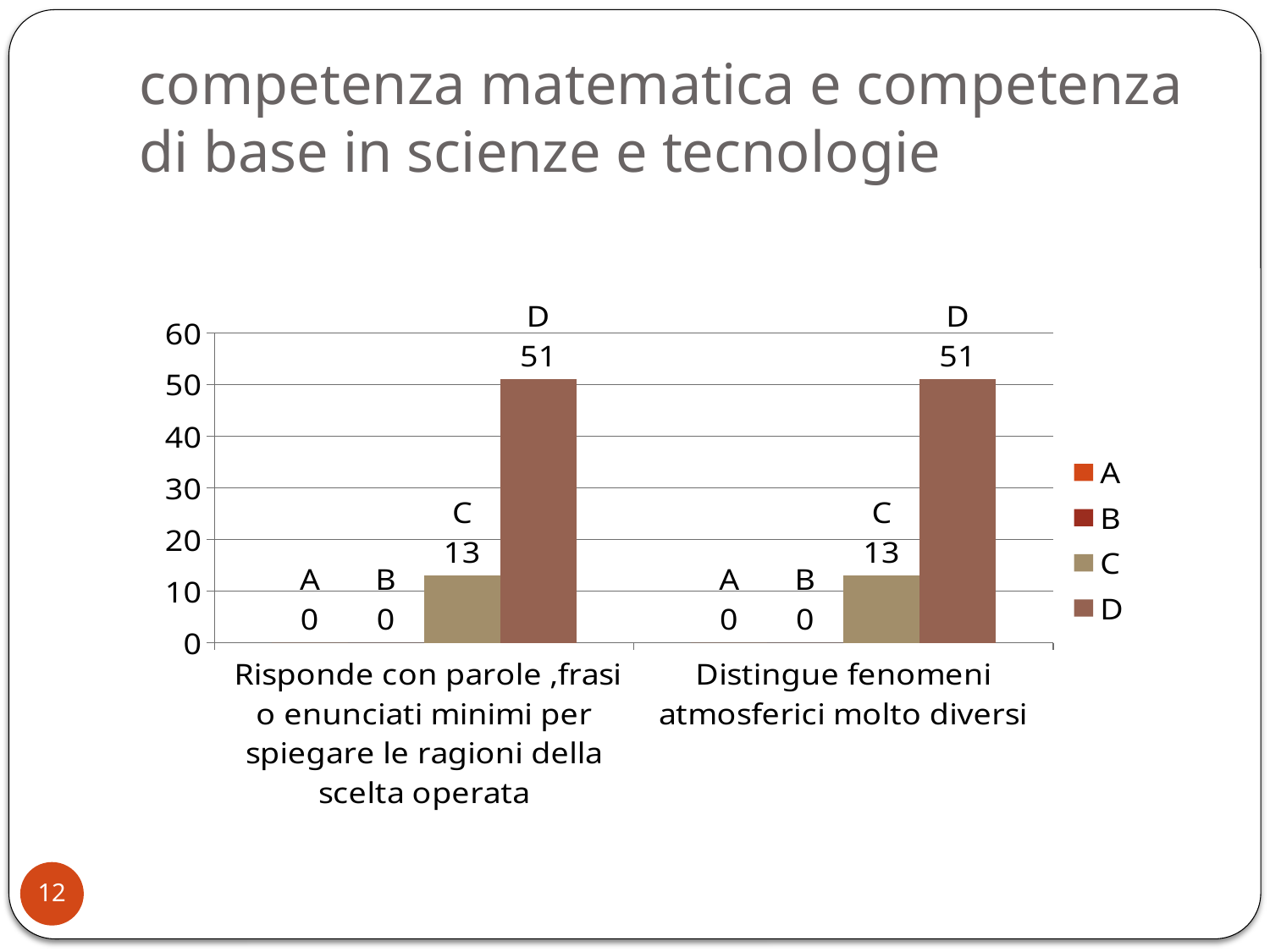
What is the value for series C in the category "Risponde con parole, frasi o enunciati minimi per spiegare le ragioni della scelta operata"? 13 Is the value for series D in the category "Distingue fenomeni atmosferici molto diversi" greater or less than 40? greater Which series has the highest value in the category "Risponde con parole, frasi o enunciati minimi per spiegare le ragioni della scelta operata"? D In the category "Distingue fenomeni atmosferici molto diversi", which is larger: the value for series C or the value for series D? D What is the value for series D in the category "Distingue fenomeni atmosferici molto diversi"? 51 How many categories are shown on the x axis of the chart? 2 How many series does the legend list? 4 What is the highest value shown on the vertical axis of the chart? 60 What is the value for series A in the category "Distingue fenomeni atmosferici molto diversi"? 0 What is the total of the values for series A, B, C and D in the category "Risponde con parole, frasi o enunciati minimi per spiegare le ragioni della scelta operata"? 64 What kind of chart is shown on the slide? bar chart What is the difference between the values for series D and series C in the category "Distingue fenomeni atmosferici molto diversi"? 38